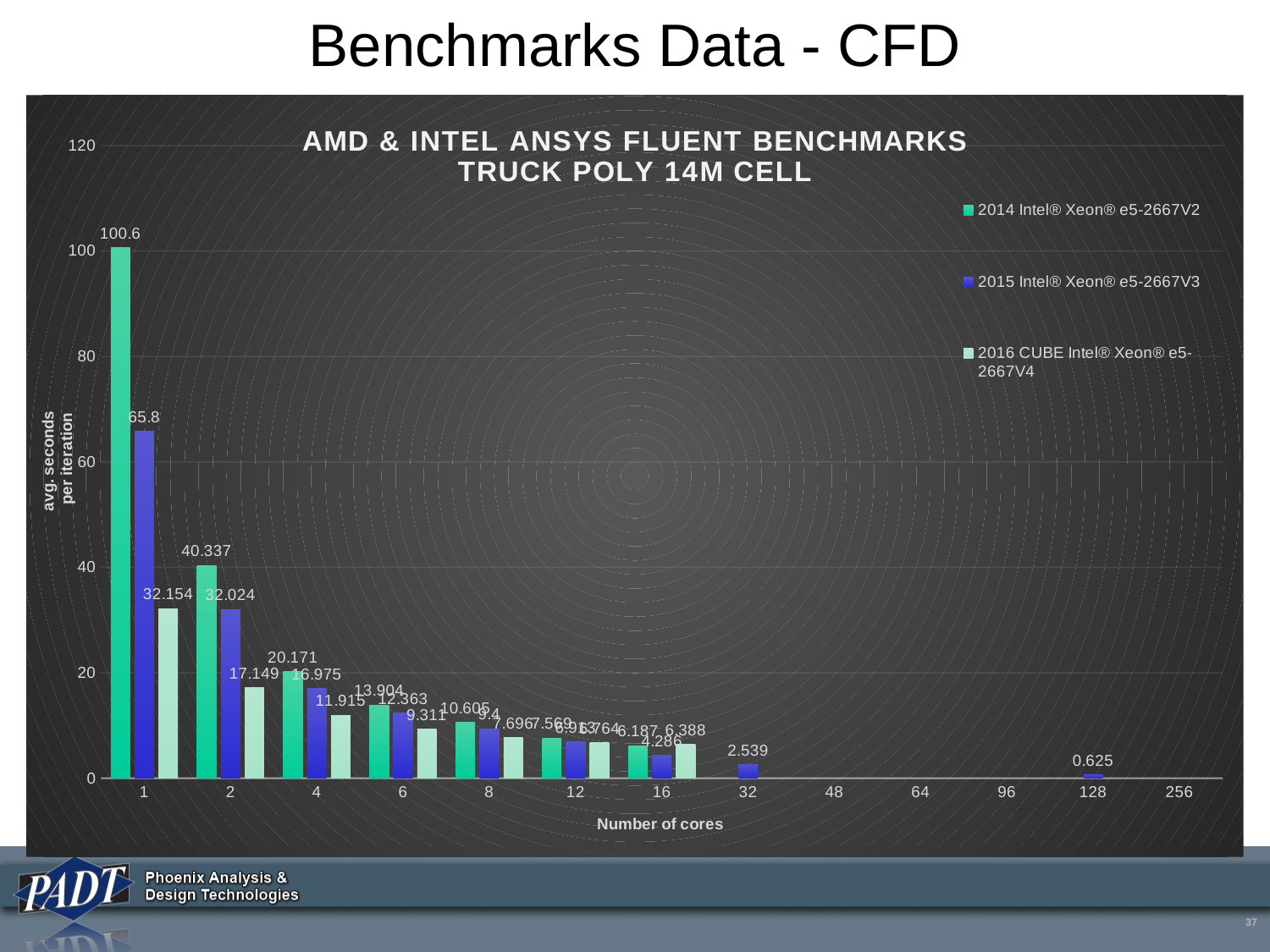
What kind of chart is shown on the slide? Bar chart What is the avg. seconds per iteration for the 2014 Intel® Xeon® e5-2667V2 at 1 core? 100.6 What is the difference between the 2014 Intel® Xeon® e5-2667V2 and 2015 Intel® Xeon® e5-2667V3 values at 1 core? 34.8 What value is shown for the 2015 Intel® Xeon® e5-2667V3 at 128 cores? 0.625 Is the value for the 2015 Intel® Xeon® e5-2667V3 at 1 core greater or less than 60? greater What value is shown for the 2015 Intel® Xeon® e5-2667V3 at 32 cores? 2.539 How many series does the legend list? 3 What value is shown for the 2014 Intel® Xeon® e5-2667V2 at 2 cores? 40.337 How many core-count categories are shown on the x axis? 13 Which series and core count has the highest avg. seconds per iteration? 2014 Intel® Xeon® e5-2667V2 at 1 core At 2 cores, which series has the larger value: 2014 Intel® Xeon® e5-2667V2 or 2015 Intel® Xeon® e5-2667V3? 2014 Intel® Xeon® e5-2667V2 What is the avg. seconds per iteration for the 2015 Intel® Xeon® e5-2667V3 at 1 core? 65.8